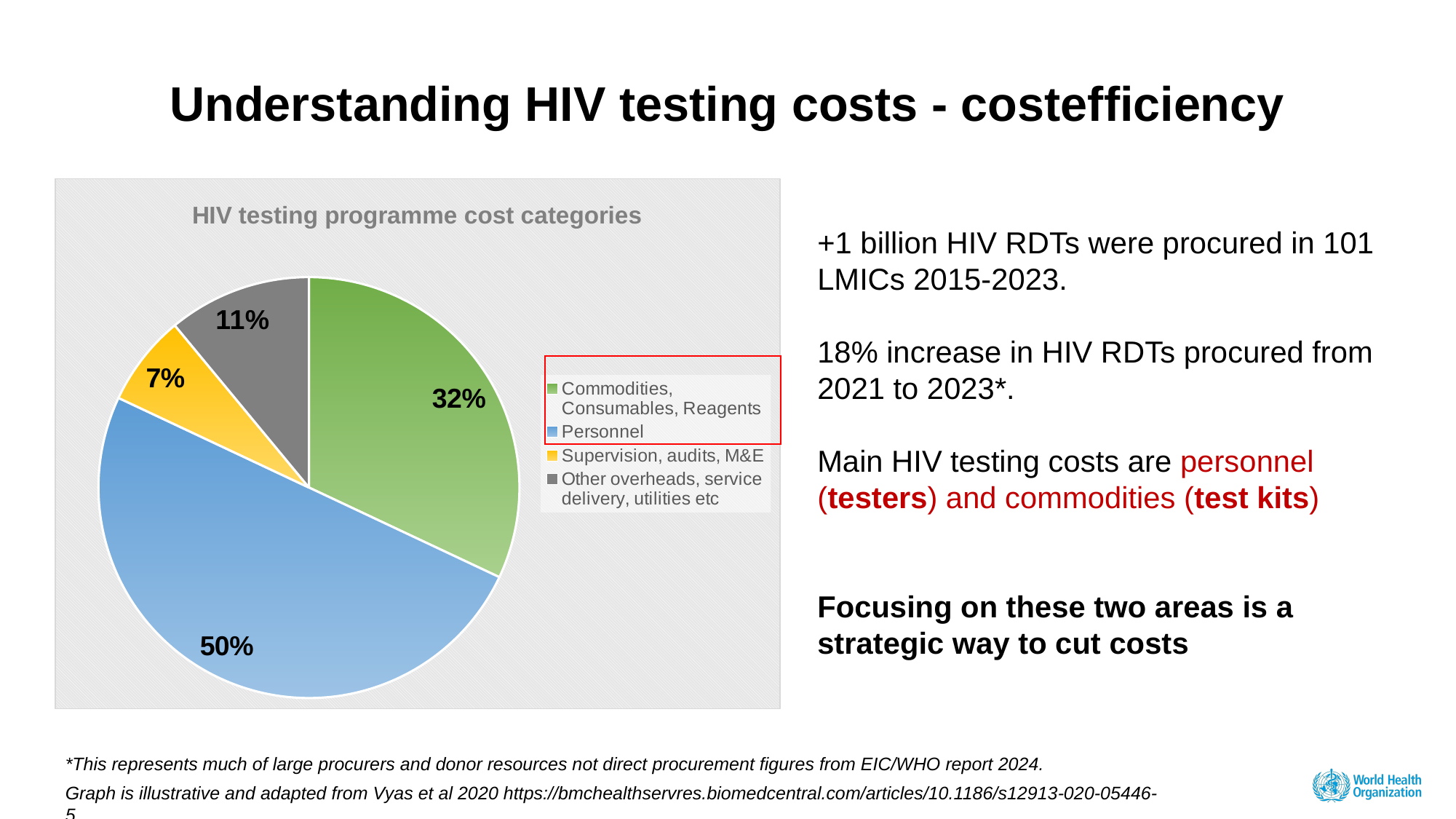
How many categories does the pie chart show? 4 What type of chart is shown on the slide? Pie chart Which is larger: the share for Other overheads, service delivery, utilities etc or the share for Supervision, audits, M&E? Other overheads, service delivery, utilities etc What share of costs is Other overheads, service delivery, utilities etc? 11% What is the title of the chart? HIV testing programme cost categories Which cost category has the largest share of the pie? Personnel What colour is the Personnel slice in the pie chart? Blue What share of costs is Supervision, audits, M&E? 7% Which cost category has the smallest share of the pie? Supervision, audits, M&E What share of HIV testing programme costs is Personnel? 50% What is the difference in percentage points between Personnel and Commodities, Consumables, Reagents? 18 What share of costs is Commodities, Consumables, Reagents? 32%